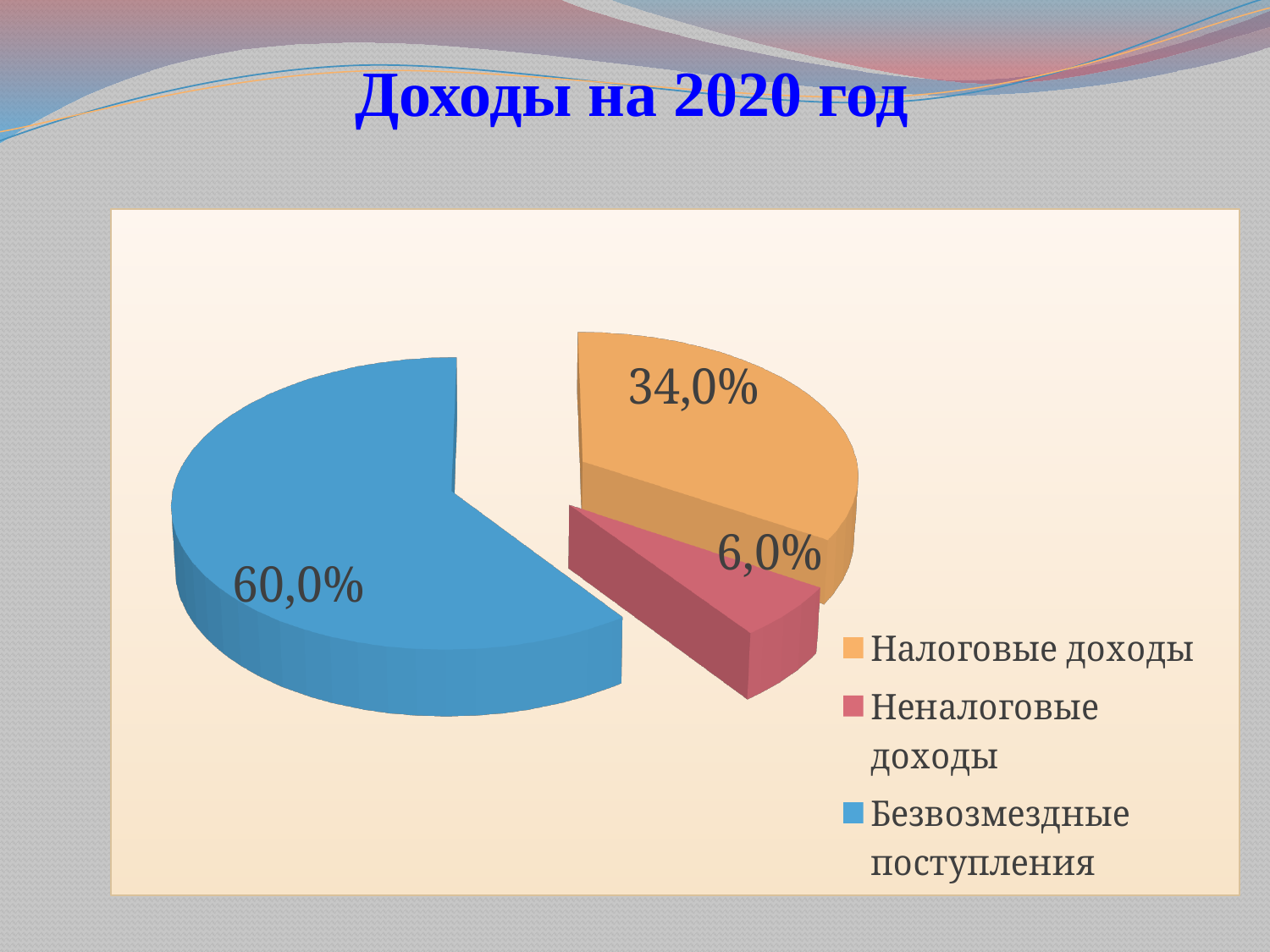
What is the difference in percentage points between Налоговые доходы and Неналоговые доходы? 28,0% Which category has the largest slice of the pie? Безвозмездные поступления Which is larger, Налоговые доходы or Неналоговые доходы? Налоговые доходы What share of the pie does Безвозмездные поступления represent? 60,0% What share of the pie does Налоговые доходы represent? 34,0% What is the difference in percentage points between Безвозмездные поступления and Налоговые доходы? 26,0% What share of the pie does Неналоговые доходы represent? 6,0% Which category has the smallest slice of the pie? Неналоговые доходы What is the title of the slide? Доходы на 2020 год How many categories does the pie chart show? 3 What kind of chart is shown on the slide? Pie chart What colour is the slice for Безвозмездные поступления? Blue